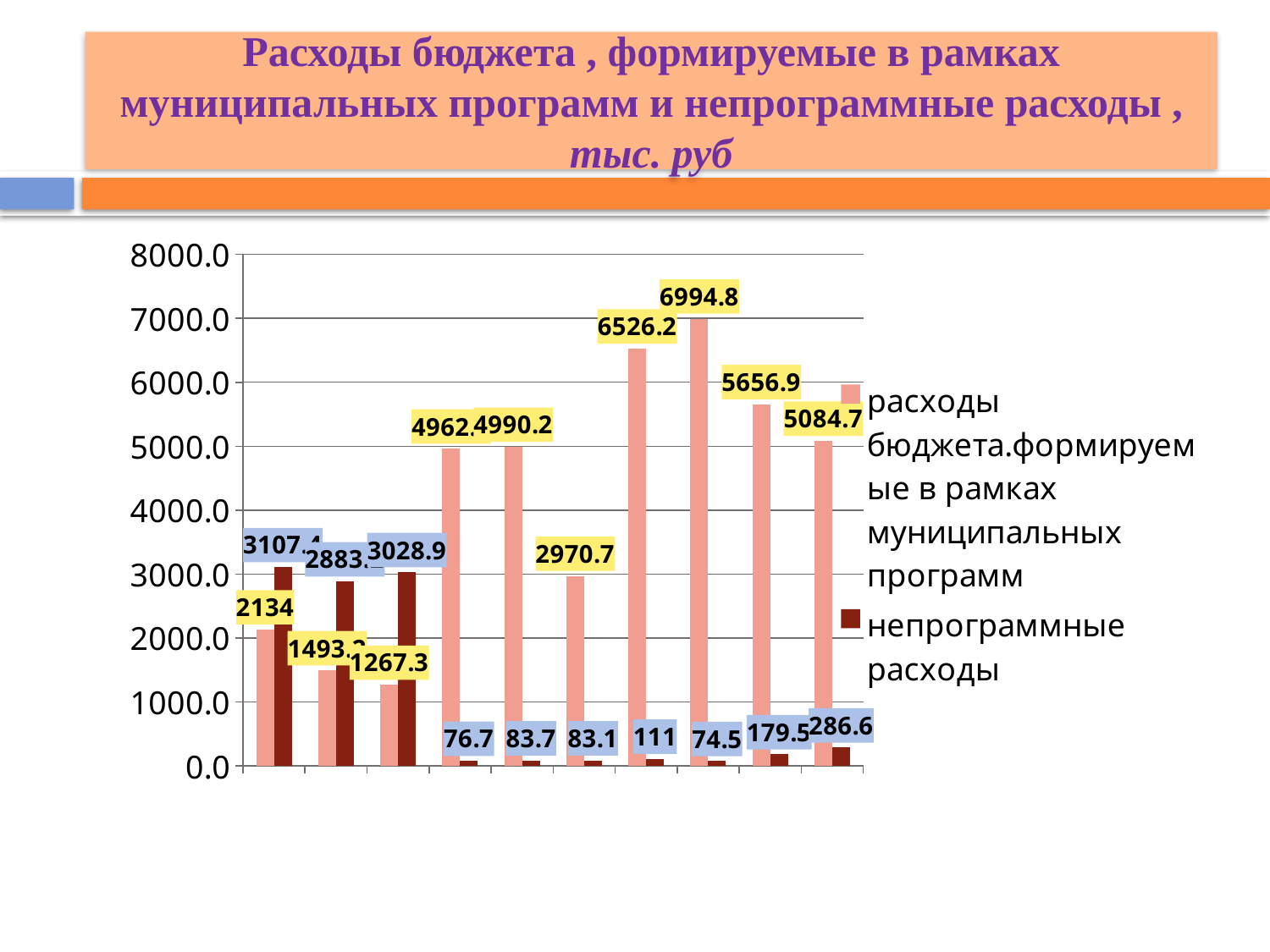
What is the difference between the two highest values of the series 'расходы бюджета, формируемые в рамках муниципальных программ' (6994.8 and 6526.2)? 468.6 What kind of chart is shown on the slide? bar chart Which is larger among the last two values of the 'расходы бюджета, формируемые в рамках муниципальных программ' series: 5656.9 or 5084.7? 5656.9 What is the difference between the highest and lowest values of the series 'расходы бюджета, формируемые в рамках муниципальных программ'? 5727.5 What is the highest value shown for the series 'расходы бюджета, формируемые в рамках муниципальных программ'? 6994.8 How many series does the legend list? 2 What is the lowest value shown for the series 'непрограммные расходы'? 74.5 Which series is drawn in dark red bars? непрограммные расходы Is the highest bar of the 'расходы бюджета, формируемые в рамках муниципальных программ' series greater or less than 6000? greater What is the maximum value shown on the vertical axis? 8000.0 What is the lowest value shown for the series 'расходы бюджета, формируемые в рамках муниципальных программ'? 1267.3 How many categories (groups of bars) are plotted on the chart? 10